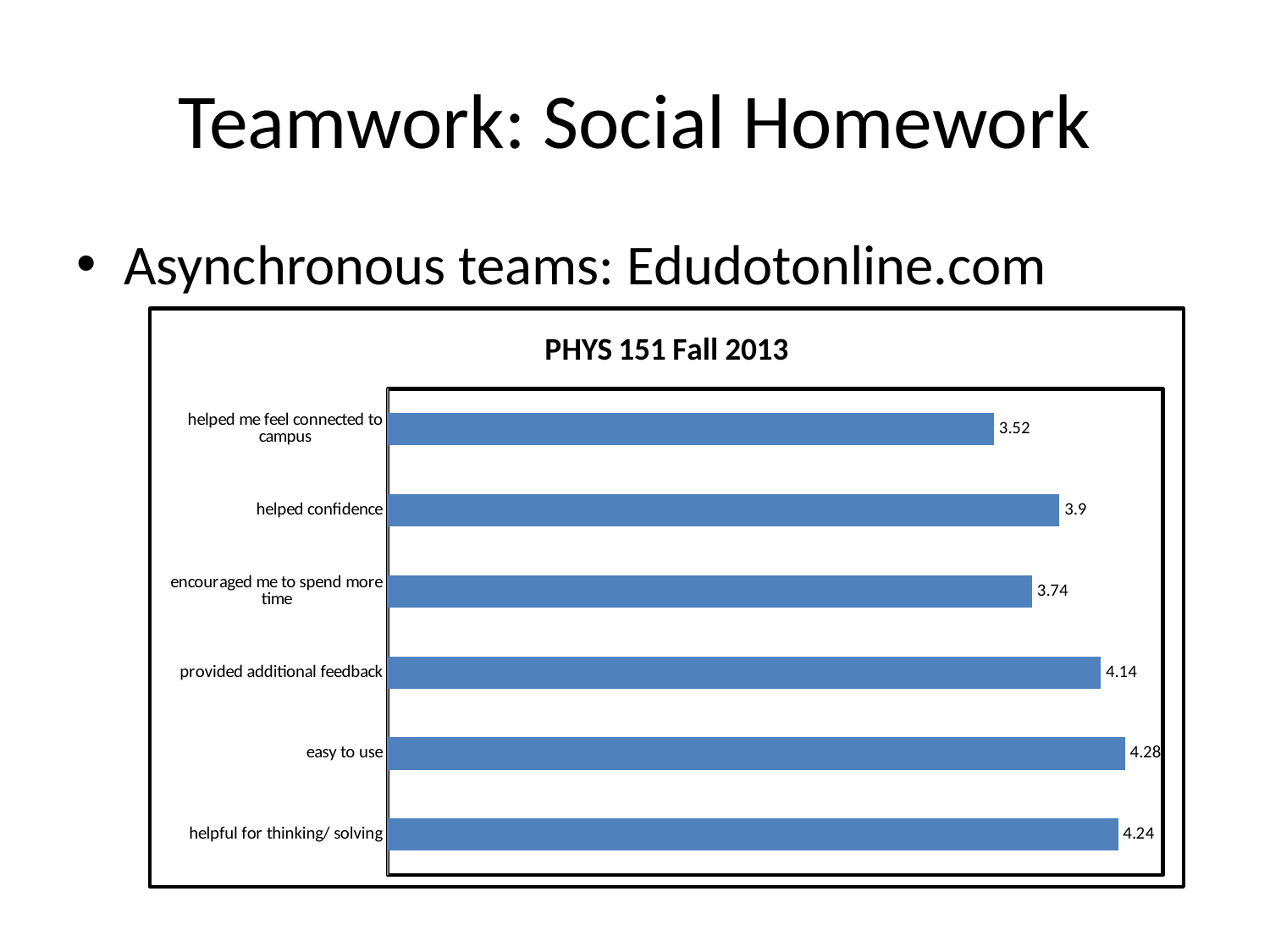
Which category has the lowest value? helped me feel connected to campus What is the difference between the values for "provided additional feedback" and "encouraged me to spend more time"? 0.4 What is the title of the chart? PHYS 151 Fall 2013 What is the value for "helped me feel connected to campus"? 3.52 What is the value for "helped confidence"? 3.9 What is the value for "provided additional feedback"? 4.14 Which category has the highest value? easy to use How many categories are shown in the chart? 6 What kind of chart is shown on the slide? bar chart Which has a larger value, "helped confidence" or "encouraged me to spend more time"? helped confidence What is the difference between the values for "easy to use" and "helped me feel connected to campus"? 0.76 What is the value for "easy to use"? 4.28